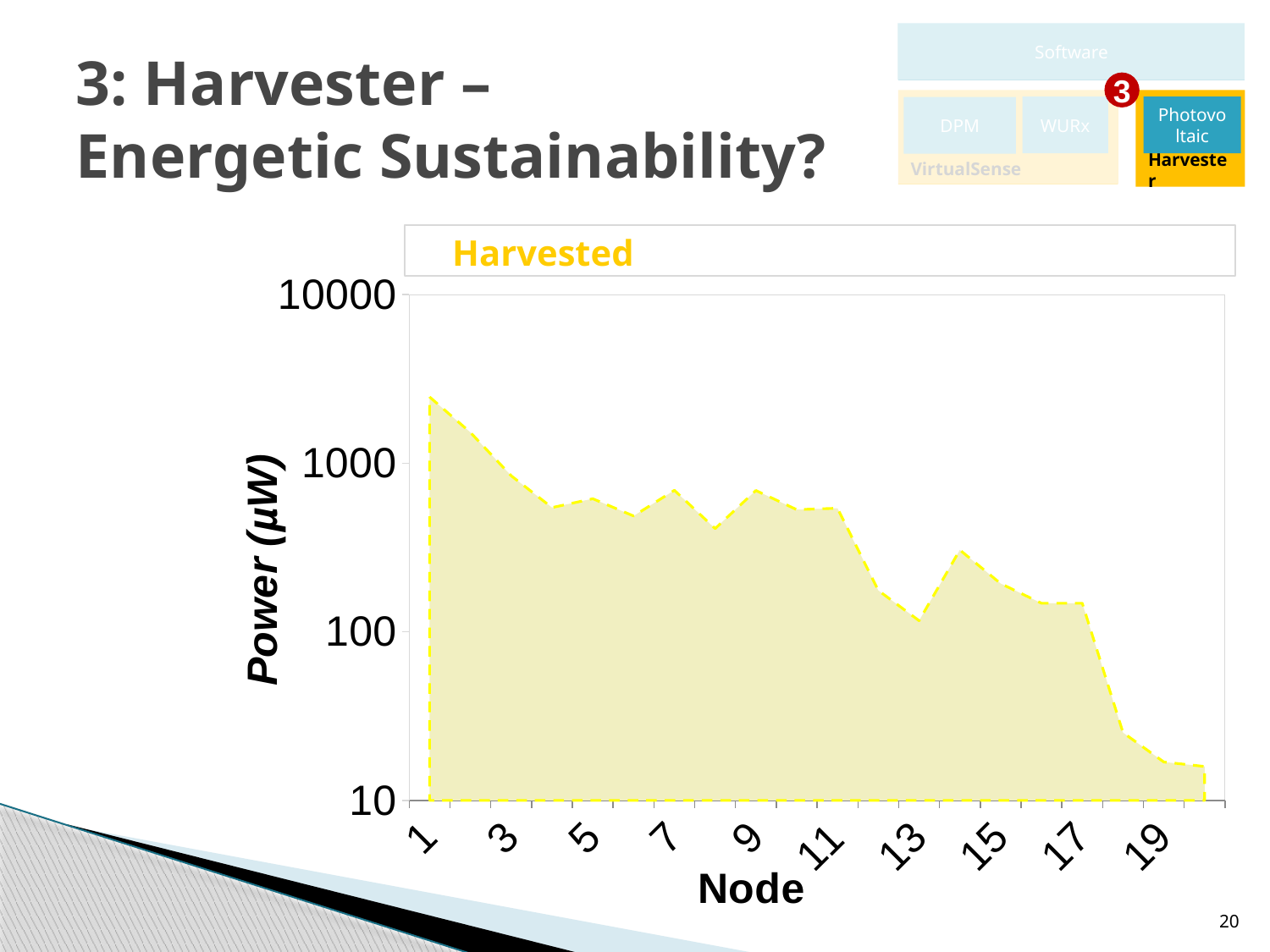
How many series does the chart legend list? 1 Overall, does the harvested power rise or fall as the node number increases? fall Which has the higher harvested power, node 1 or node 19? node 1 What kind of chart is shown on the slide? area chart Is the harvested power for node 5 greater or less than 1000? less Is the harvested power for node 19 greater or less than 100? less Is the harvested power for node 1 greater or less than 1000? greater What is the name of the series shown in the chart legend? Harvested What is the label of the y axis of the chart? Power (µW) Which node has the highest harvested power? 1 Which has the higher harvested power, node 5 or node 13? node 5